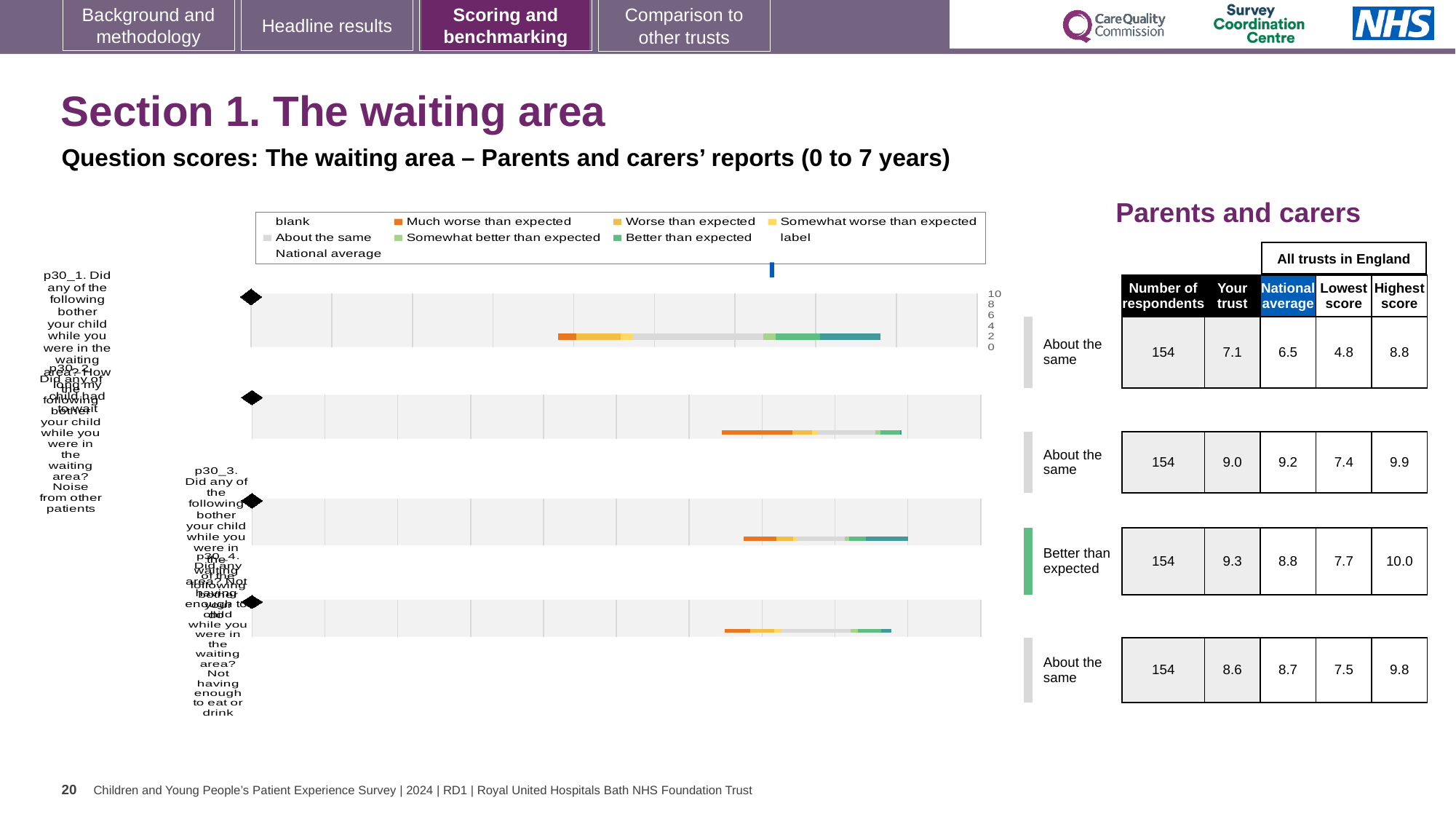
Which question has the highest trust score in the table next to the chart? p30_3 What kind of chart is shown on the slide? Bar chart What is the difference between the trust score and the national average for question p30_1? 0.6 Which legend entry is shown in orange? Much worse than expected In the table next to the chart, what is the highest score for question p30_4 (not having enough to eat or drink)? 9.8 Which question has the lowest trust score in the table next to the chart? p30_1 How many question bars are plotted in the chart? 4 Which legend entry is shown in teal/dark green? Better than expected In the table next to the chart, what is the number of respondents for question p30_1? 154 Which question is rated 'Better than expected' in the table next to the chart? p30_3